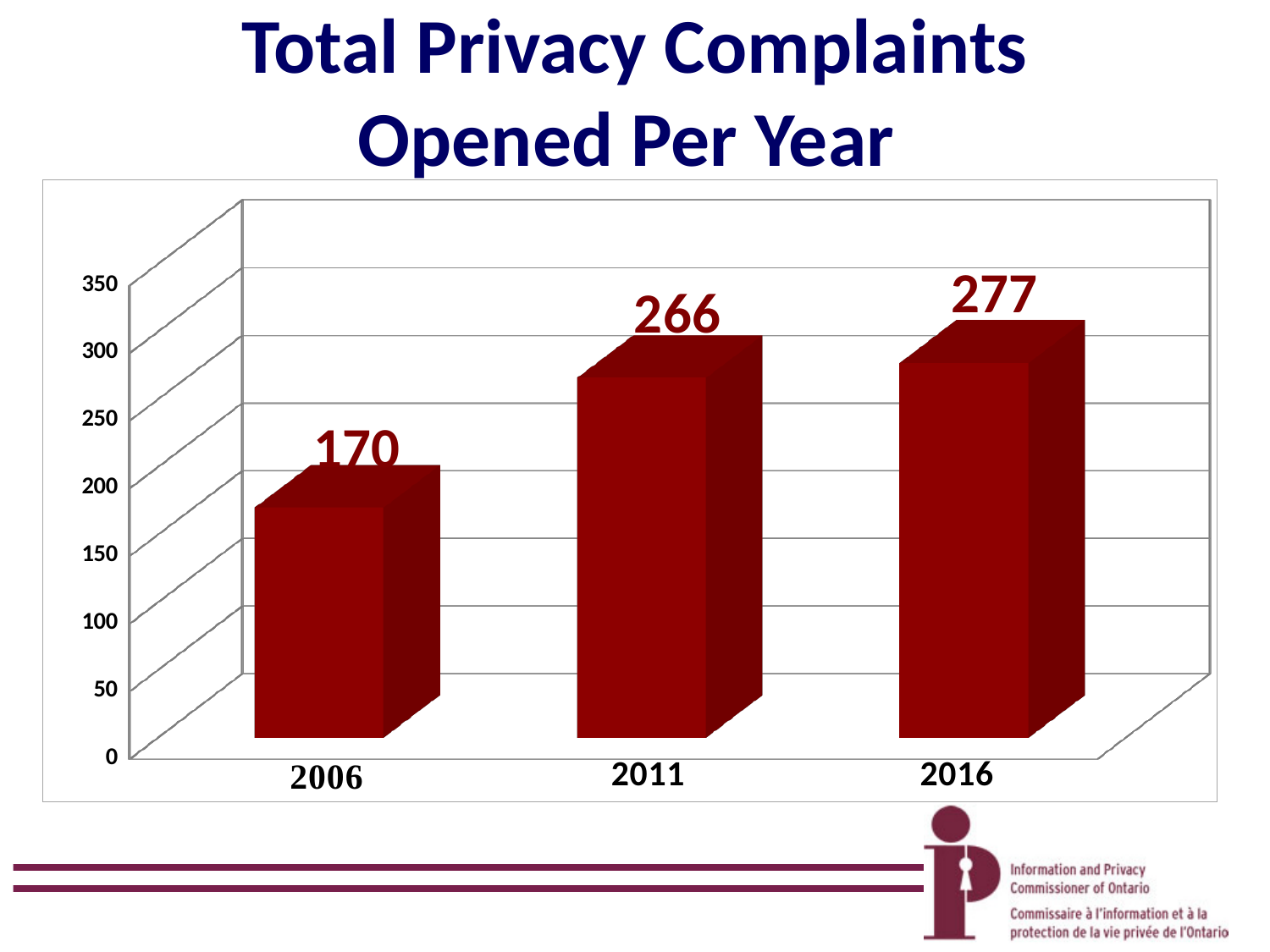
Which year has the lowest number of privacy complaints opened? 2006 What is the difference between the values for 2016 and 2011? 11 Do the values rise or fall from 2006 to 2016? rise What is the difference between the values for 2011 and 2006? 96 Is the value for 2006 greater or less than 200? less What kind of chart is shown on the slide? bar chart What is the value for 2016? 277 What is the value for 2006? 170 How many years are shown on the chart? 3 Which is larger, the value for 2006 or the value for 2011? 2011 Which year has the highest number of privacy complaints opened? 2016 What is the value for 2011? 266